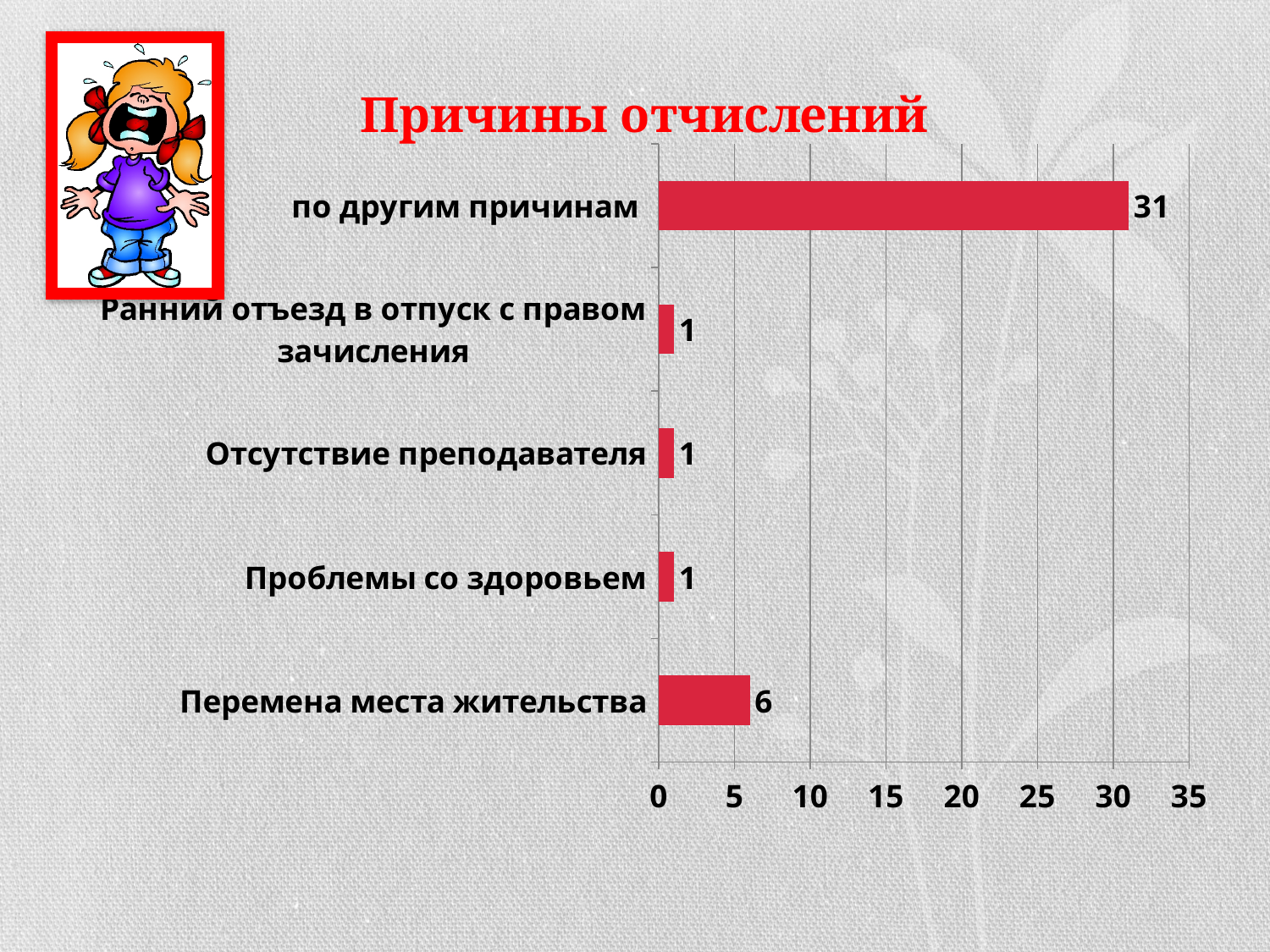
What is the difference between the values for "по другим причинам" and "Перемена места жительства"? 25 What kind of chart is shown on the slide? bar chart What is the value for "по другим причинам"? 31 Is the value for "Перемена места жительства" greater or less than 10? less What is the title of the chart? Причины отчислений What is the value for "Проблемы со здоровьем"? 1 What is the value for "Отсутствие преподавателя"? 1 Which is larger: the value for "Перемена места жительства" or the value for "Проблемы со здоровьем"? Перемена места жительства How many categories are shown in the chart? 5 Is the value for "по другим причинам" greater or less than 30? greater Which category has the highest value? по другим причинам What is the value for "Перемена места жительства"? 6